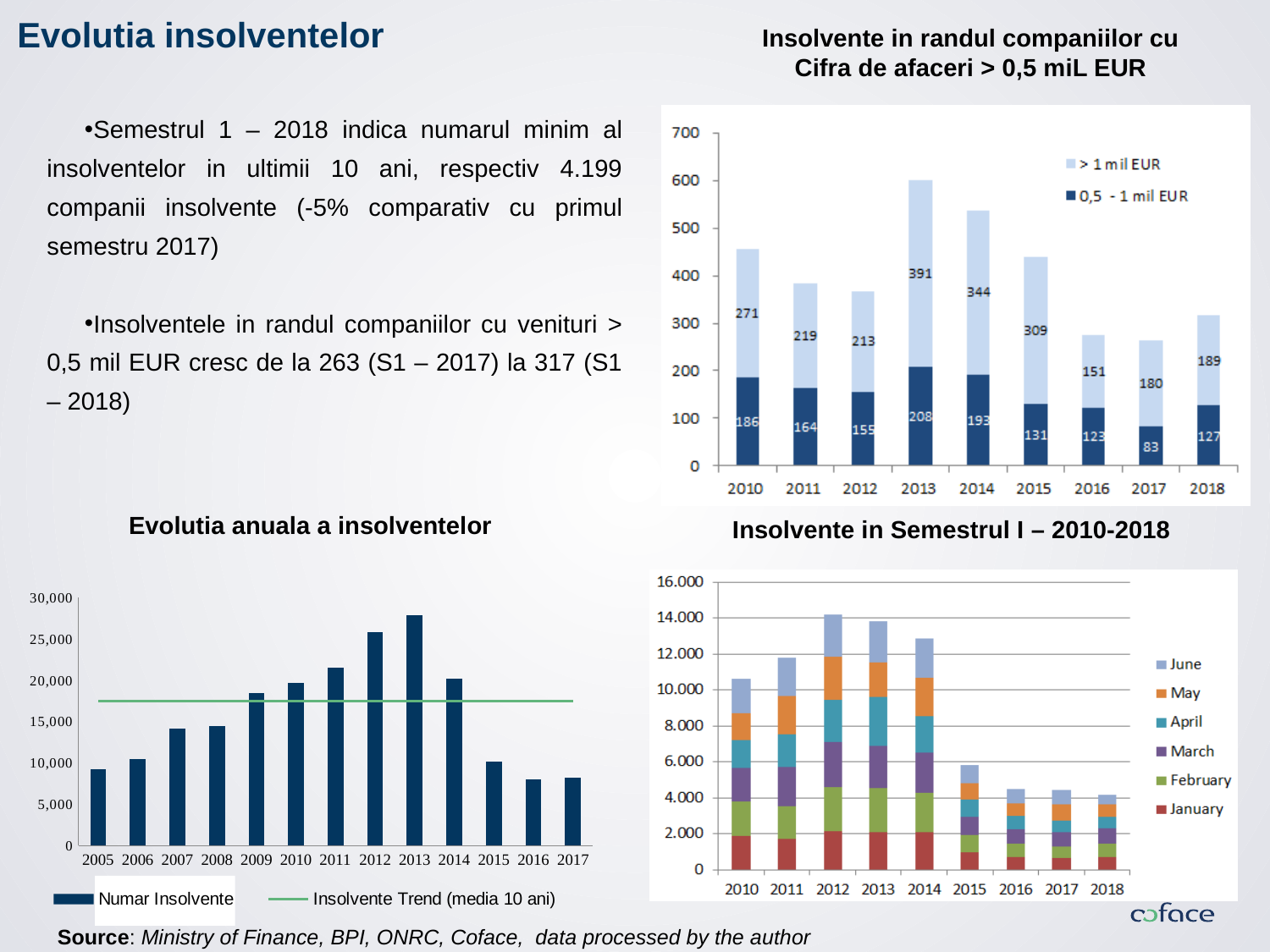
In the chart 'Insolvente in randul companiilor cu Cifra de afaceri > 0,5 miL EUR', how many series does the legend list? 2 In the chart 'Evolutia anuala a insolventelor', how many years are shown on the x axis? 13 In the chart 'Insolvente in Semestrul I – 2010-2018', how many series does the legend list? 6 In the chart 'Evolutia anuala a insolventelor', is the value for 2005 greater or less than 10,000? less In the chart 'Insolvente in randul companiilor cu Cifra de afaceri > 0,5 miL EUR', what is the total of the stacked bar for 2017? 263 In the chart 'Insolvente in randul companiilor cu Cifra de afaceri > 0,5 miL EUR', what is the value of the '> 1 mil EUR' series for 2013? 391 In the chart 'Insolvente in randul companiilor cu Cifra de afaceri > 0,5 miL EUR', what is the difference between the '> 1 mil EUR' values for 2013 and 2014? 47 In the chart 'Insolvente in randul companiilor cu Cifra de afaceri > 0,5 miL EUR', what is the value of the '0,5 - 1 mil EUR' series for 2017? 83 In the chart 'Insolvente in randul companiilor cu Cifra de afaceri > 0,5 miL EUR', which year has the highest value for the '> 1 mil EUR' series? 2013 In the chart 'Insolvente in Semestrul I – 2010-2018', which year has the tallest stacked bar? 2012 In the chart 'Evolutia anuala a insolventelor', which year has the highest number of insolvencies? 2013 In the chart 'Insolvente in randul companiilor cu Cifra de afaceri > 0,5 miL EUR', which year has the lowest value for the '0,5 - 1 mil EUR' series? 2017